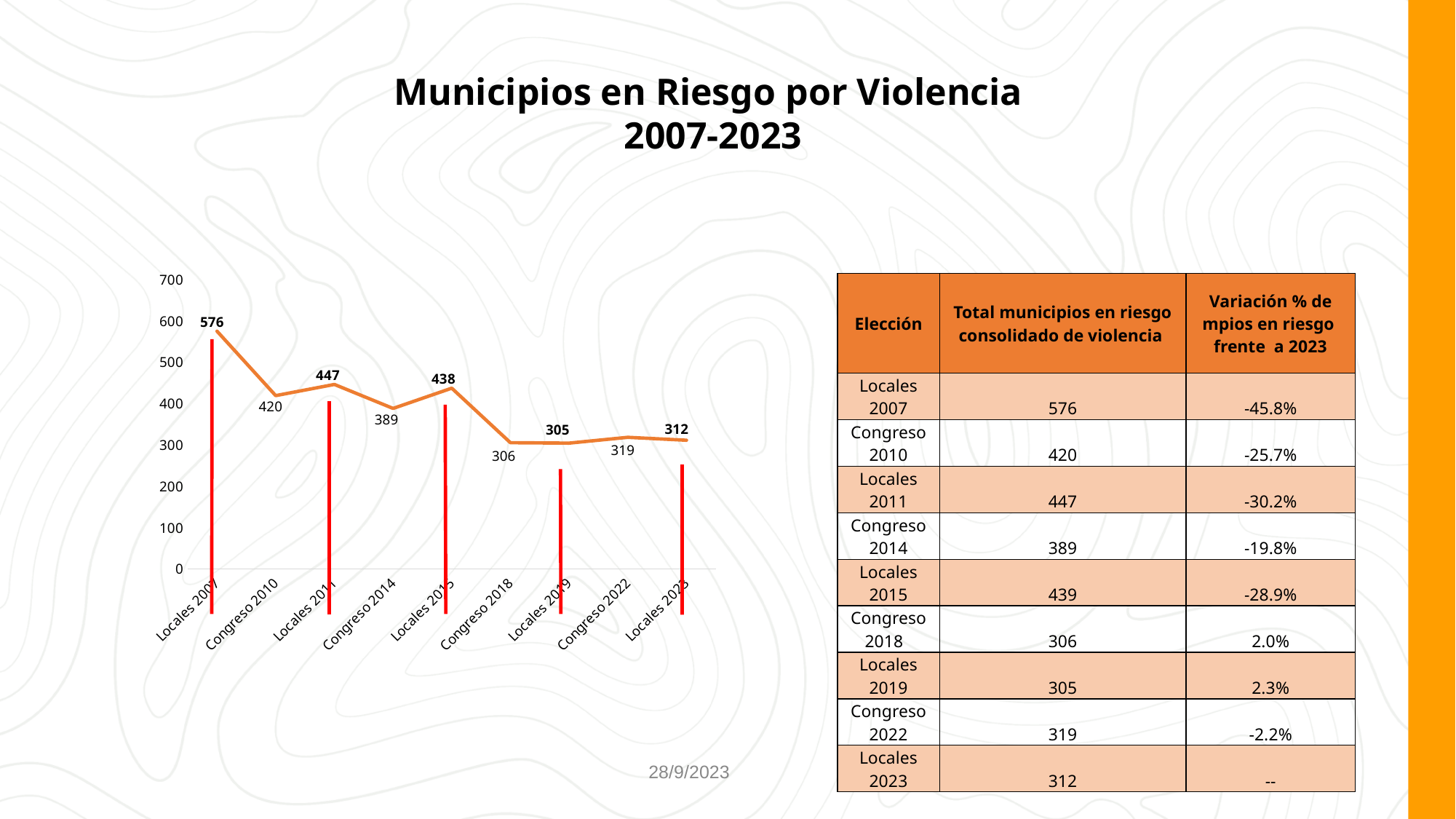
What is the difference between the values for Locales 2007 and Congreso 2010? 156 How many elections are plotted on the chart? 9 What is the value for Congreso 2018 on the chart? 306 What is the value for Locales 2023 on the chart? 312 Which election has the highest value on the chart? Locales 2007 Do the values on the chart generally rise or fall from Locales 2007 to Locales 2023? fall Which is larger, the value for Locales 2011 or the value for Locales 2015? Locales 2011 What is the value for Congreso 2014 on the chart? 389 What kind of chart is shown on the slide? line chart Which election has the lowest value on the chart? Locales 2019 Is the value for Congreso 2022 greater or less than 400? less What is the value for Locales 2007 on the chart? 576